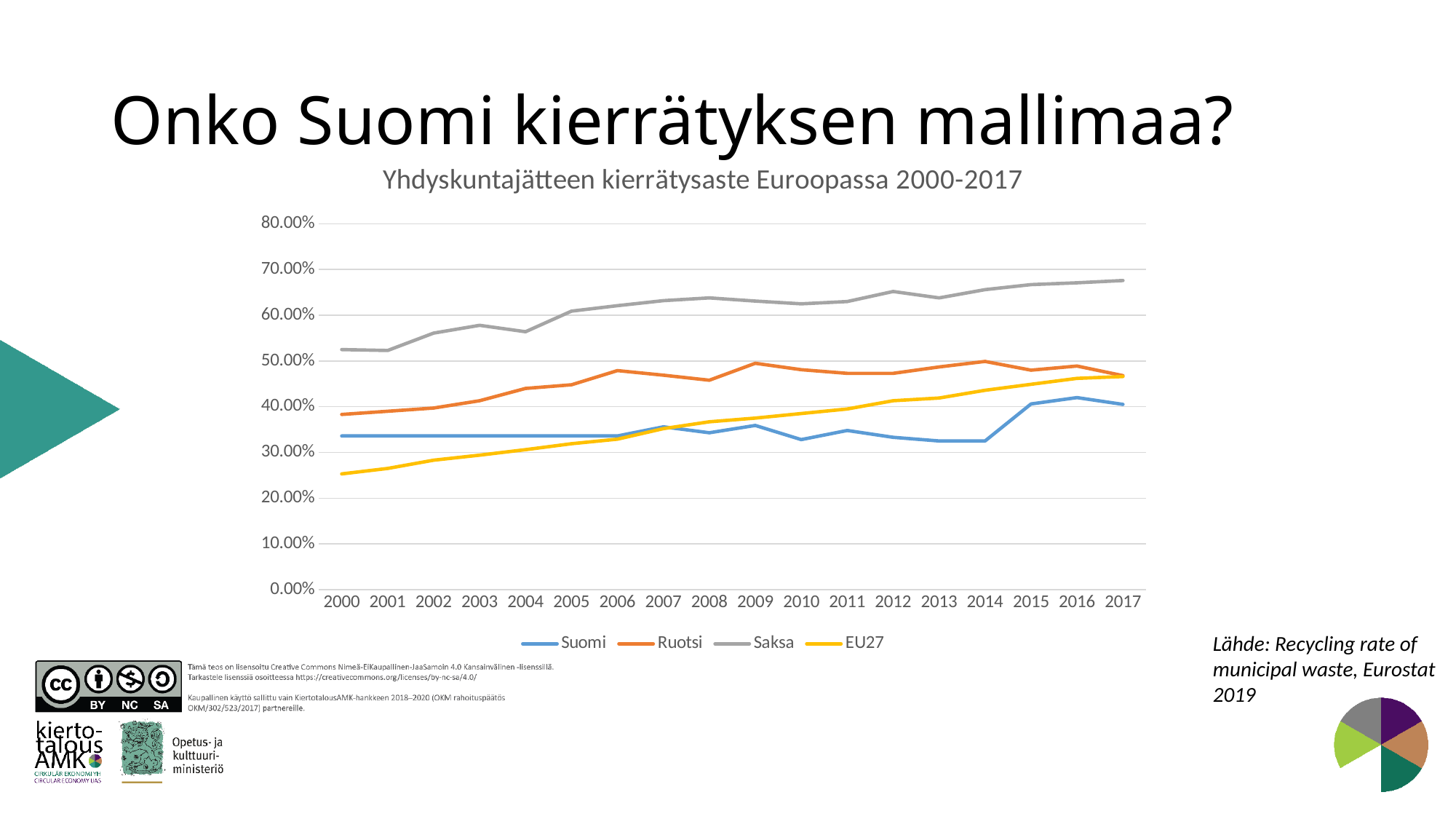
Which colour is used for the Suomi line? blue What is the title of the chart? Yhdyskuntajätteen kierrätysaste Euroopassa 2000-2017 Is the value for EU27 in 2000 greater or less than 30.00%? less Is the value for Suomi in 2014 greater or less than 40.00%? less How many years are plotted along the x axis? 18 How many series does the legend list? 4 Which series has the lowest recycling rate in 2000? EU27 Is the value for Saksa in 2017 greater or less than 60.00%? greater Which is higher in 2005, Ruotsi or Suomi? Ruotsi Does the EU27 line rise or fall from 2000 to 2017? rises Which series has the highest recycling rate in 2017? Saksa What kind of chart is shown on the slide? line chart